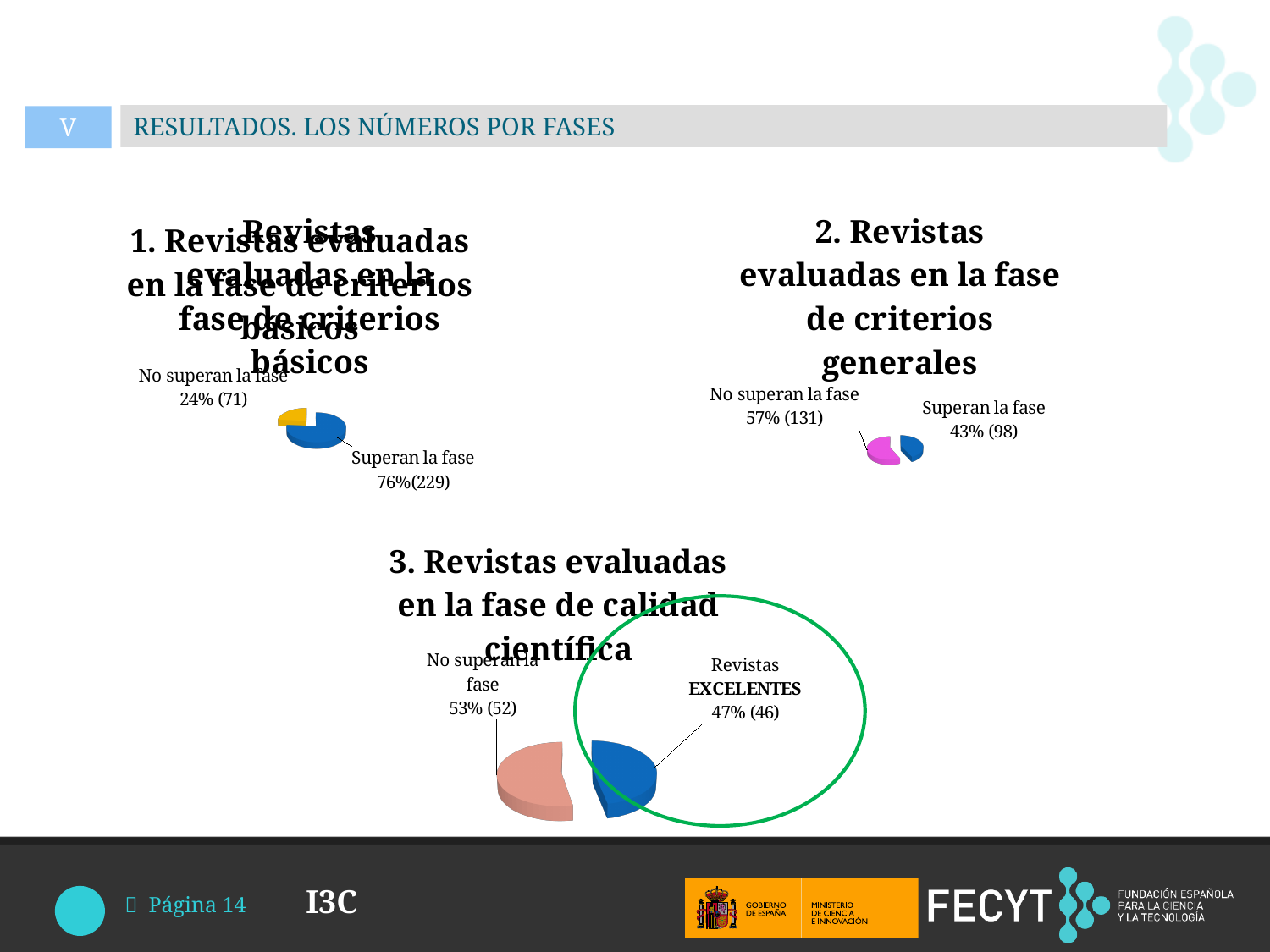
In the pie chart for the fase de calidad científica (bottom), what is the difference in number of journals between 'No superan la fase' and 'Revistas EXCELENTES'? 6 In the pie chart for the fase de criterios básicos (top left), what is the difference in number of journals between 'Superan la fase' and 'No superan la fase'? 158 In the pie chart for the fase de criterios básicos (top left), which slice is larger: 'Superan la fase' or 'No superan la fase'? Superan la fase In the pie chart for the fase de calidad científica (bottom), how many journals are labelled 'No superan la fase'? 52 In the pie chart for the fase de criterios generales (top right), what share of journals is labelled 'No superan la fase'? 57% In the pie chart for the fase de criterios generales (top right), how many journals are labelled 'Superan la fase'? 98 In the pie chart for the fase de calidad científica (bottom), what share of journals is labelled 'Revistas EXCELENTES'? 47% What type of chart is used for the fase de calidad científica (bottom)? Pie chart In the pie chart for the fase de criterios generales (top right), which slice is the largest? No superan la fase How many pie charts are shown on the slide? 3 In the pie chart for the fase de criterios básicos (top left), how many journals are labelled 'No superan la fase'? 71 In the pie chart for the fase de criterios básicos (top left), what share of journals is labelled 'Superan la fase'? 76%